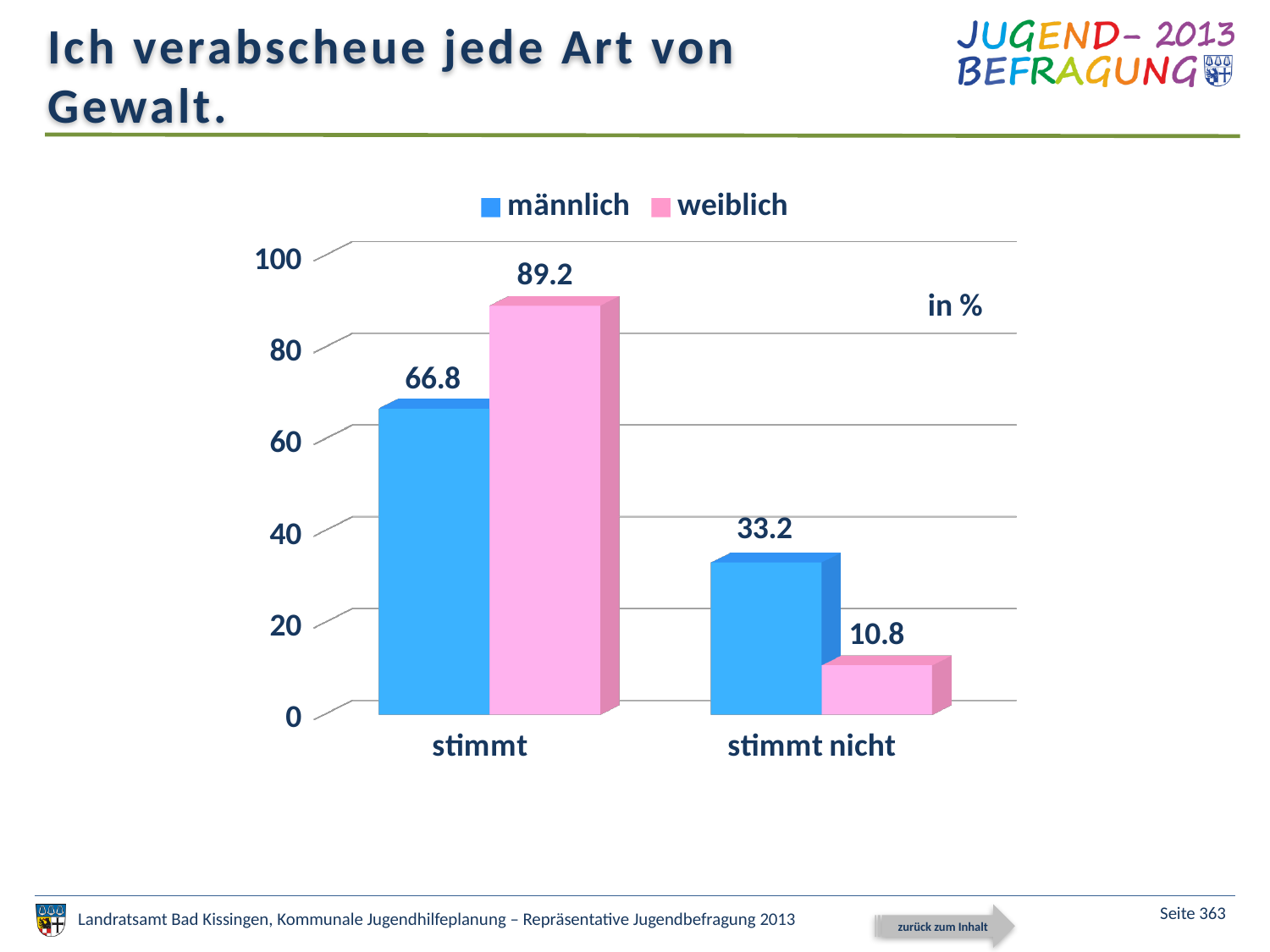
Which bar has the lowest value on the chart? weiblich, stimmt nicht Which series has the highest value in the stimmt category? weiblich Which is larger: männlich for stimmt or männlich for stimmt nicht? männlich for stimmt How many categories are shown on the x axis? 2 What kind of chart is shown on the slide? bar chart What is the difference between the weiblich and männlich values in the stimmt category? 22.4 What is the value for männlich in the stimmt category? 66.8 How many series does the legend list? 2 What is the value for weiblich in the stimmt category? 89.2 What is the value for männlich in the stimmt nicht category? 33.2 What is the difference between the männlich and weiblich values in the stimmt nicht category? 22.4 What is the value for weiblich in the stimmt nicht category? 10.8